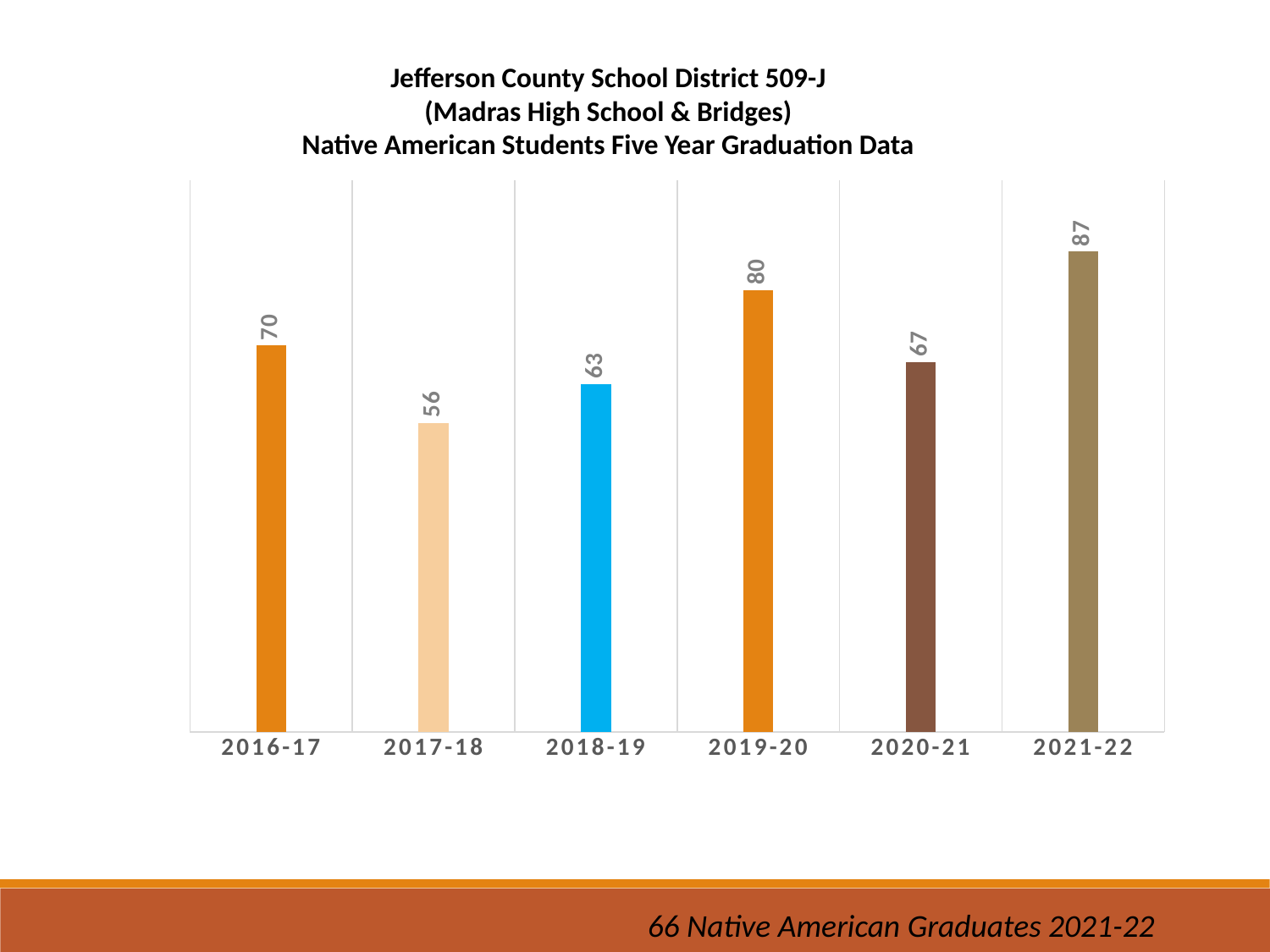
Which is larger, the value for 2016-17 or the value for 2020-21? 2016-17 What is the difference between the values for 2021-22 and 2017-18? 31 Which year has the highest value? 2021-22 What is the value for 2017-18? 56 What is the value for 2016-17? 70 What is the difference between the values for 2019-20 and 2018-19? 17 What kind of chart is this? bar chart How many years are shown on the chart? 6 Which year has the lowest value? 2017-18 What is the value for 2020-21? 67 What is the value for 2019-20? 80 What is the title of the chart? Jefferson County School District 509-J (Madras High School & Bridges) Native American Students Five Year Graduation Data